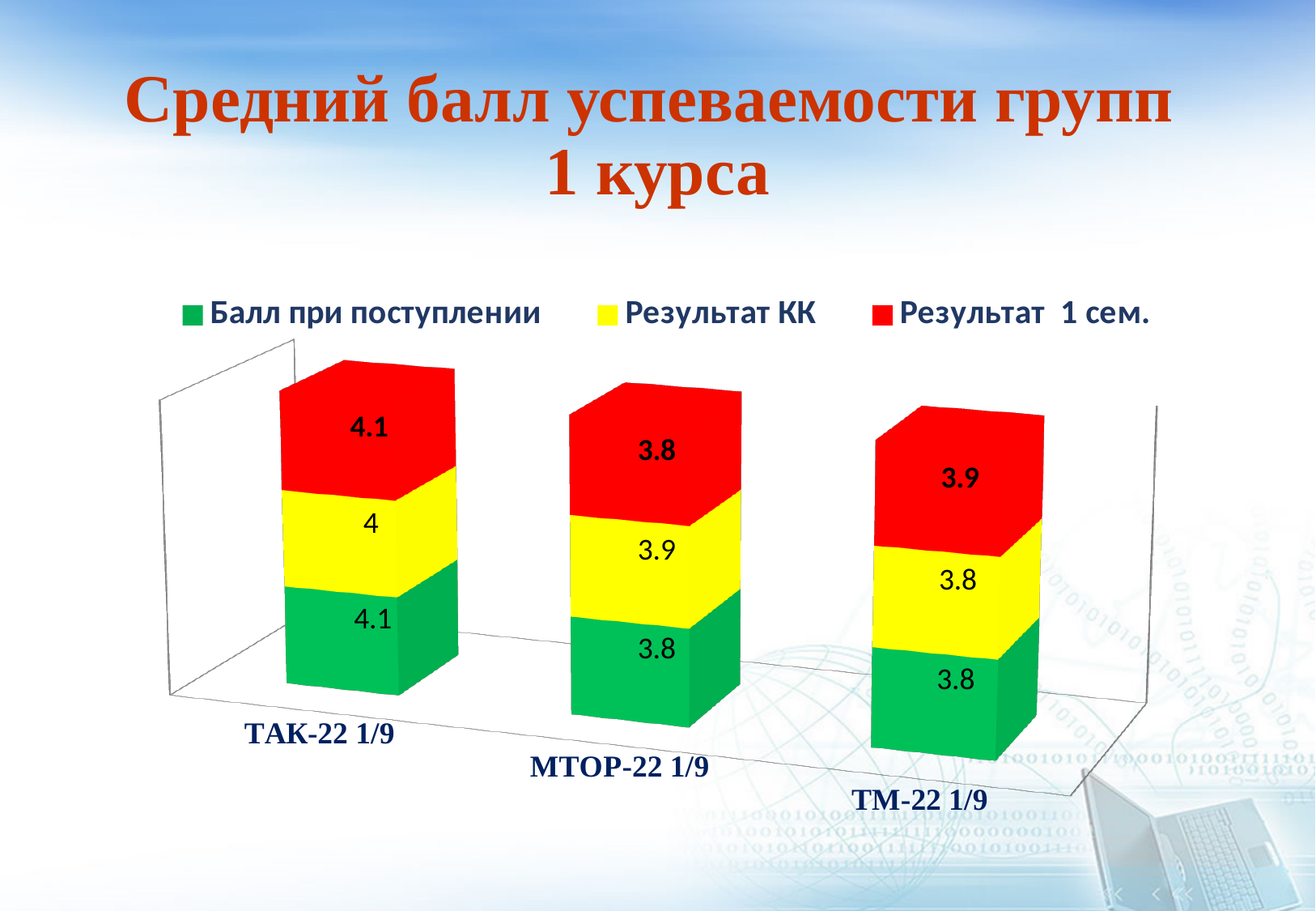
Which is larger: "Балл при поступлении" for ТАК-22 1/9 or for ТМ-22 1/9? ТАК-22 1/9 Which group has the lowest value for "Результат КК"? ТМ-22 1/9 What kind of chart is shown on the slide? Stacked bar chart What is the difference between the "Результат 1 сем." values for ТАК-22 1/9 and МТОР-22 1/9? 0.3 What is the total of the stacked bar for ТАК-22 1/9? 12.2 Which group has the highest value for "Результат 1 сем."? ТАК-22 1/9 What is the value of "Результат КК" for ТАК-22 1/9? 4 How many groups are shown on the x axis? 3 What is the value of "Результат 1 сем." for ТМ-22 1/9? 3.9 What is the value of "Балл при поступлении" for ТАК-22 1/9? 4.1 What is the value of "Результат КК" for МТОР-22 1/9? 3.9 How many series does the legend list? 3